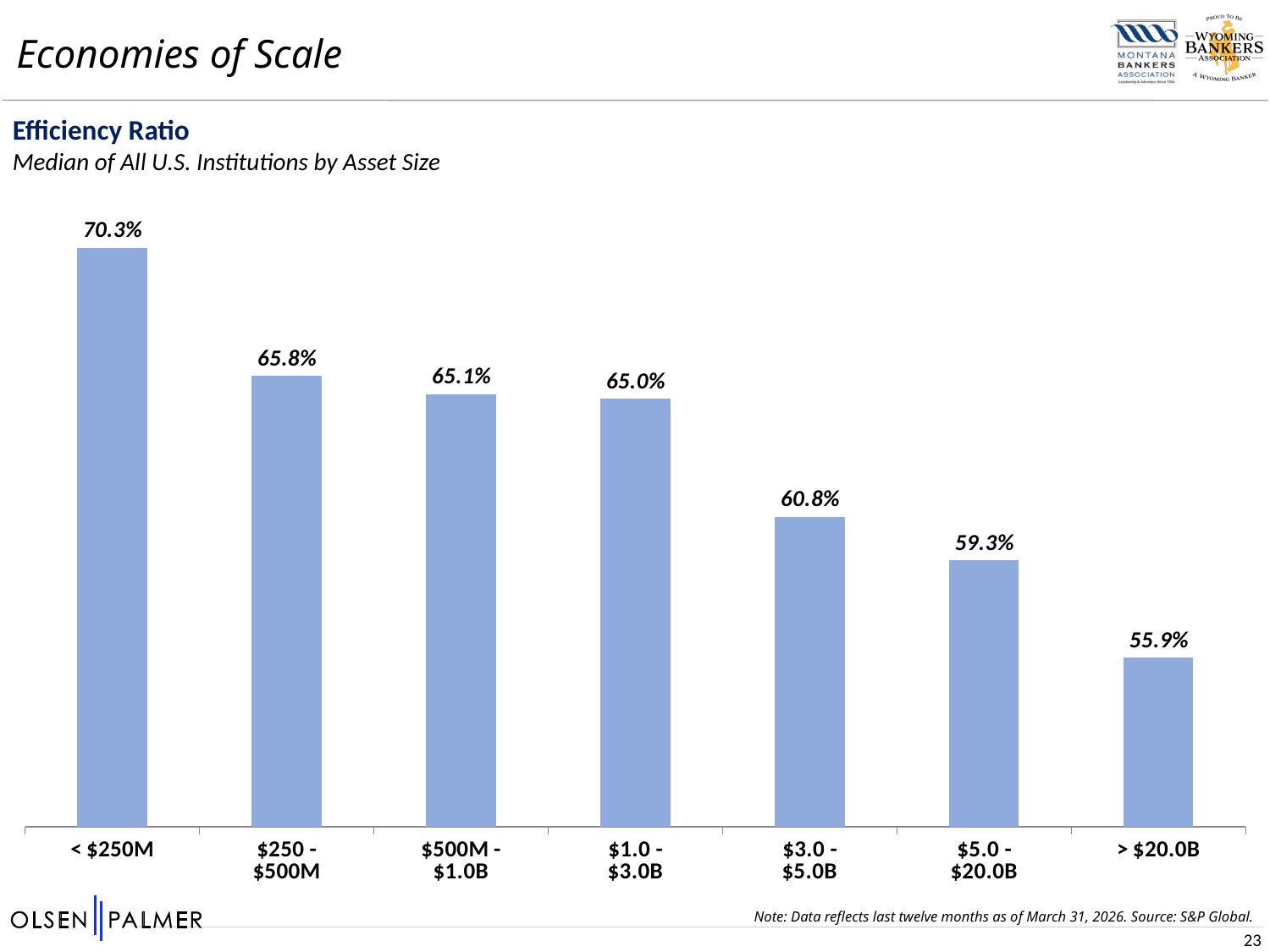
What is the difference between the efficiency ratio for < $250M and > $20.0B institutions? 14.4% What is the subtitle of the chart? Median of All U.S. Institutions by Asset Size Which asset size group has the lowest median efficiency ratio? > $20.0B How many asset size categories are shown in the chart? 7 What is the median efficiency ratio for the $1.0 - $3.0B asset size group? 65.0% What is the difference between the efficiency ratio for the $3.0 - $5.0B group and the $5.0 - $20.0B group? 1.5% Which asset size group has the highest median efficiency ratio? < $250M Which has a higher median efficiency ratio: the $250 - $500M group or the $3.0 - $5.0B group? $250 - $500M What is the median efficiency ratio for institutions with assets over $20.0B? 55.9% What type of chart is used on this slide? Bar chart What is the median efficiency ratio for institutions with assets under $250M? 70.3% Do the efficiency ratios rise or fall as asset size increases along the x axis? Fall